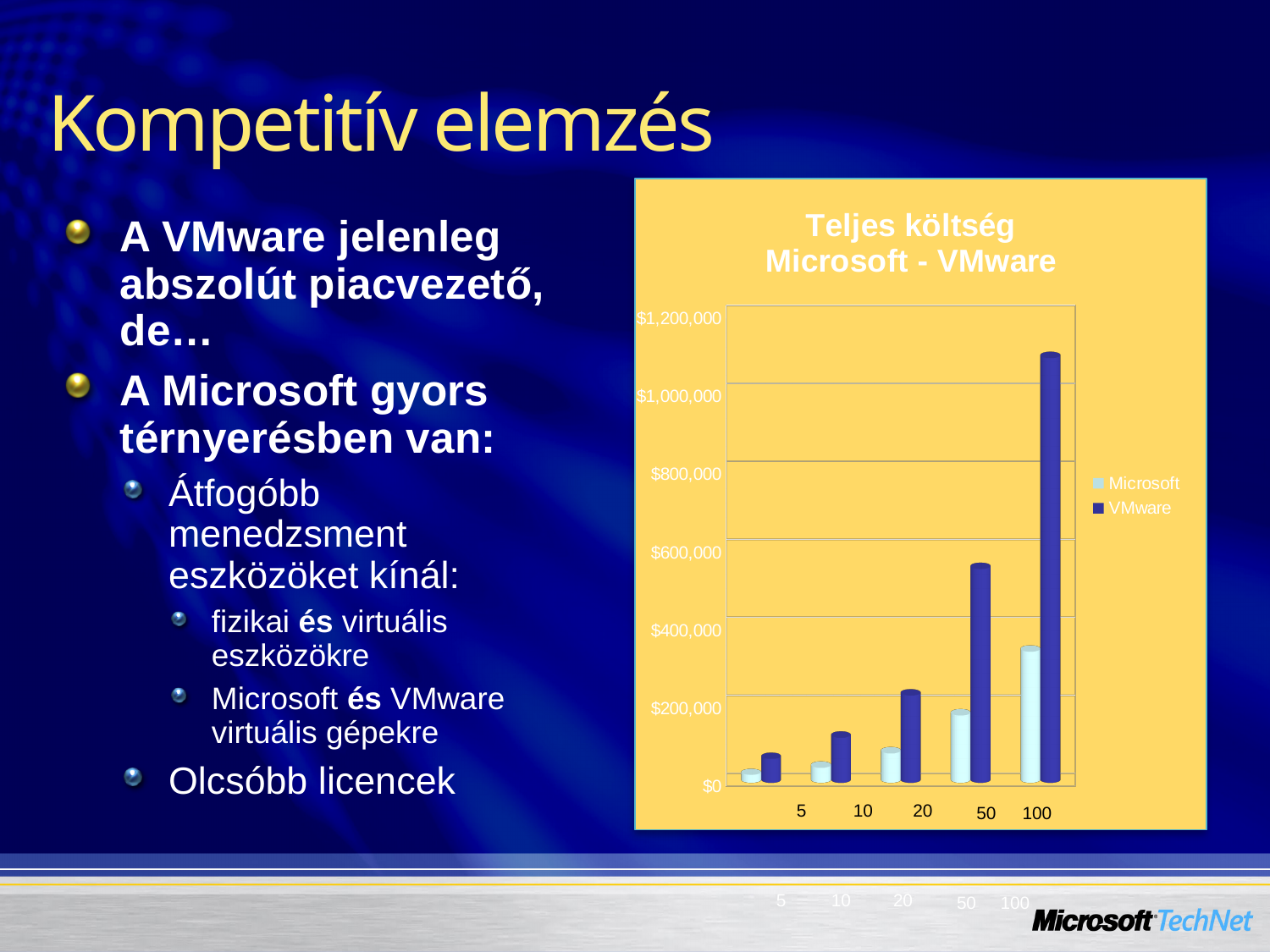
How many series does the chart's legend list? 2 For which category is the Microsoft value lowest? 5 Which series is shown in dark blue in the chart? VMware What kind of chart is shown on the slide? bar chart At category 100, which series has the larger value, Microsoft or VMware? VMware Do the VMware values rise or fall as the categories increase from 5 to 100? rise Is the VMware value for category 100 greater or less than $1,000,000? greater How many categories are shown on the x axis of the chart? 5 Is the Microsoft value for category 100 greater or less than $400,000? less What is the title of the chart? Teljes költség Microsoft - VMware Is the VMware value for category 50 greater or less than $400,000? greater For which category is the VMware value highest? 100